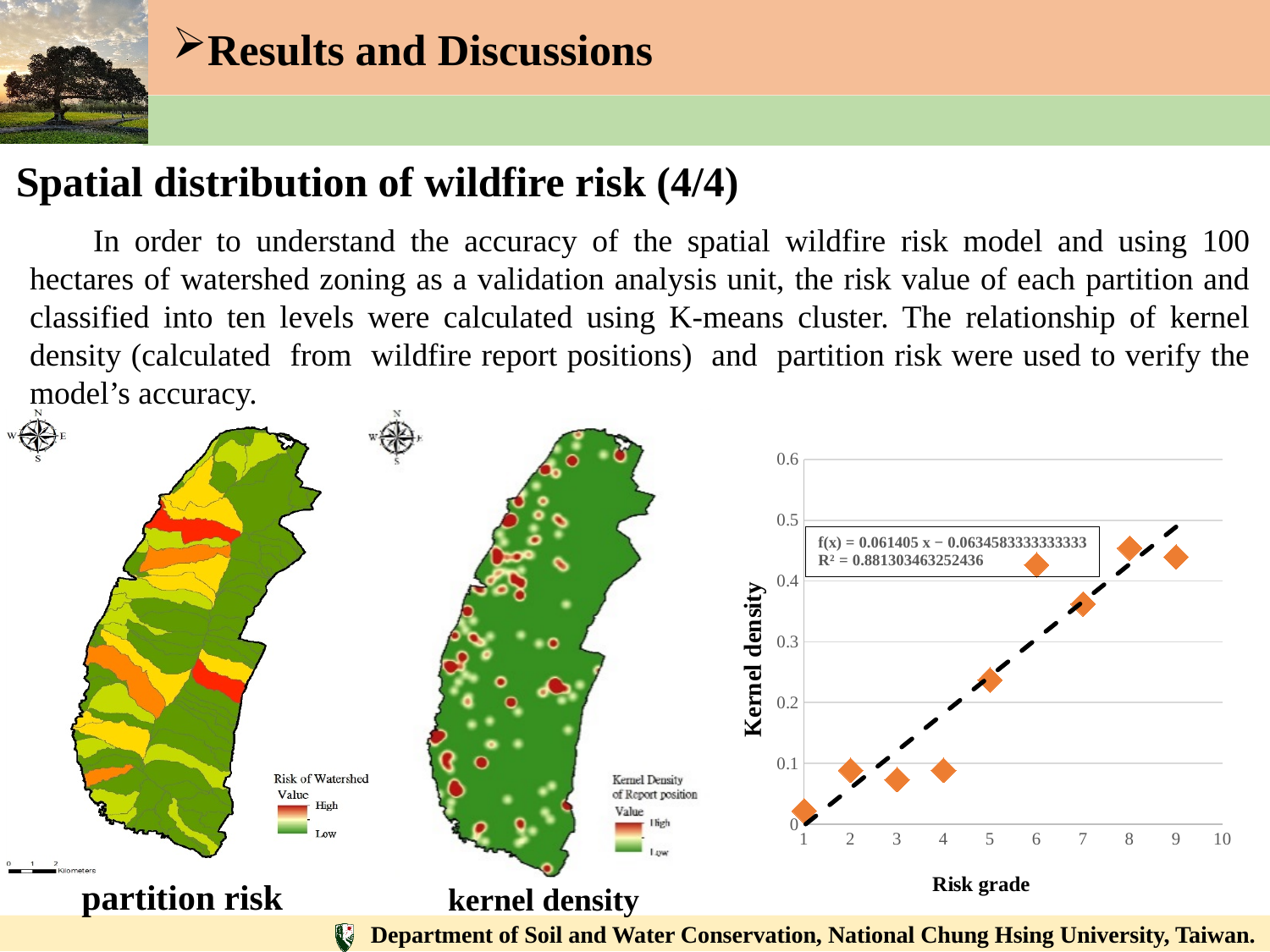
In the scatter chart, does kernel density generally rise or fall as risk grade increases? rise Which has the higher kernel density in the scatter chart, risk grade 6 or risk grade 7? risk grade 6 Is the kernel density for risk grade 3 greater or less than 0.1? less Which risk grade has the lowest kernel density in the scatter chart? 1 Is the kernel density for risk grade 8 greater or less than 0.4? greater Is the kernel density for risk grade 1 greater or less than 0.1? less What is the label of the x axis of the scatter chart? Risk grade How many data points are plotted in the scatter chart? 9 What kind of chart is shown on the right of the slide? scatter chart Which has the higher kernel density in the scatter chart, risk grade 5 or risk grade 4? risk grade 5 What is the R² value shown on the scatter chart? 0.881303463252436